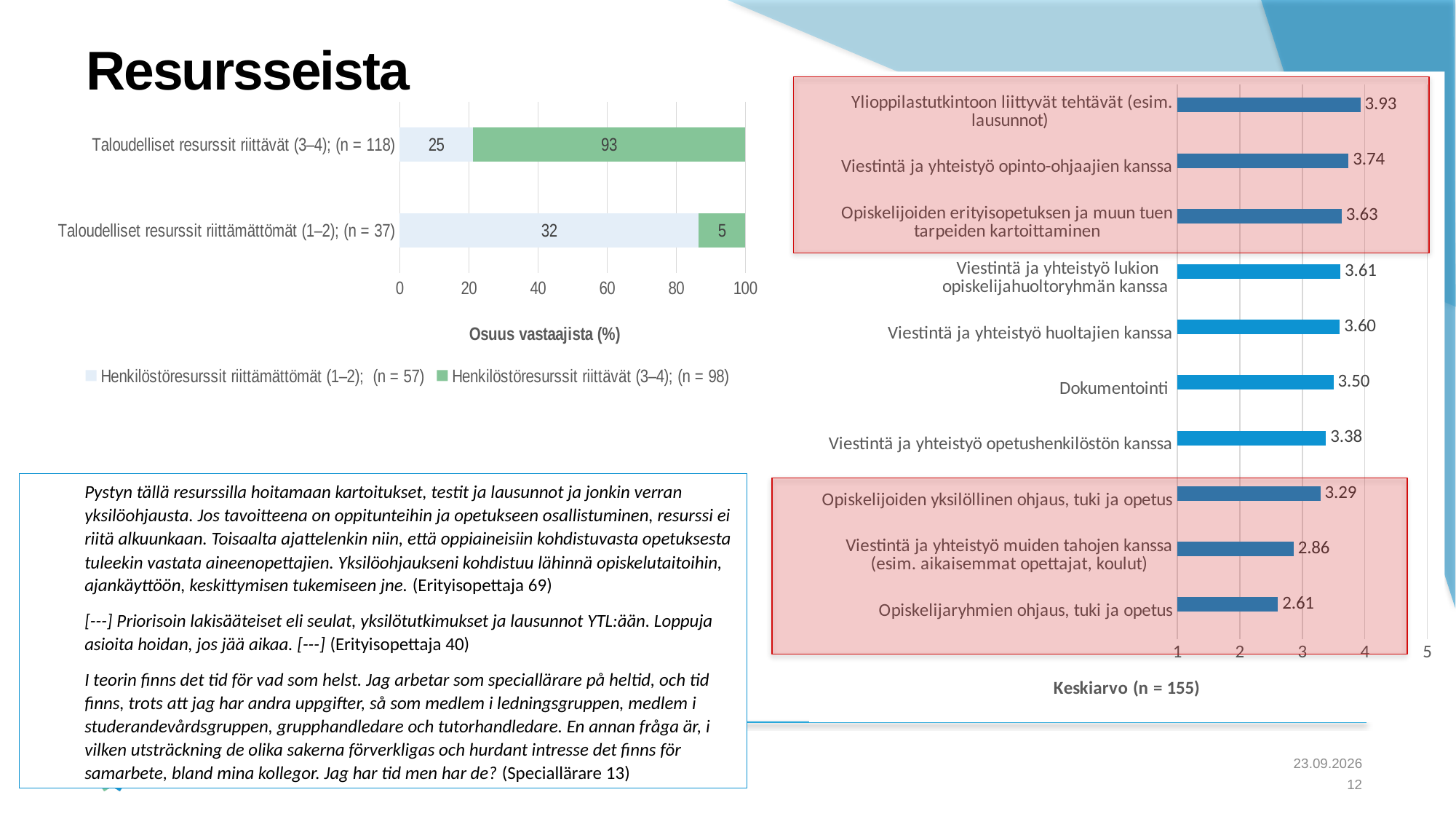
In the 'Keskiarvo (n = 155)' chart on the right, what is the value for 'Dokumentointi'? 3.50 In the 'Keskiarvo (n = 155)' chart on the right, which category has the lowest value? Opiskelijaryhmien ohjaus, tuki ja opetus In the 'Keskiarvo (n = 155)' chart on the right, is the value for 'Viestintä ja yhteistyö opetushenkilöstön kanssa' greater or less than 3? greater What kind of chart is the 'Keskiarvo (n = 155)' chart on the right? Bar chart In the 'Osuus vastaajista (%)' chart on the left, how many series does the legend list? 2 In the 'Keskiarvo (n = 155)' chart on the right, what is the difference between the values for 'Viestintä ja yhteistyö opinto-ohjaajien kanssa' and 'Viestintä ja yhteistyö muiden tahojen kanssa (esim. aikaisemmat opettajat, koulut)'? 0.88 In the 'Osuus vastaajista (%)' chart on the left, what is the total of the two segments for 'Taloudelliset resurssit riittämättömät (1–2); (n = 37)'? 37 In the 'Osuus vastaajista (%)' chart on the left, what is the value of the 'Henkilöstöresurssit riittämättömät (1–2); (n = 57)' segment for 'Taloudelliset resurssit riittämättömät (1–2); (n = 37)'? 32 In the 'Osuus vastaajista (%)' chart on the left, which series is shown in green? Henkilöstöresurssit riittävät (3–4); (n = 98) In the 'Keskiarvo (n = 155)' chart on the right, how many categories are plotted? 10 In the 'Osuus vastaajista (%)' chart on the left, what is the value of the 'Henkilöstöresurssit riittävät (3–4); (n = 98)' segment for 'Taloudelliset resurssit riittävät (3–4); (n = 118)'? 93 In the 'Keskiarvo (n = 155)' chart on the right, which category has the highest value? Ylioppilastutkintoon liittyvät tehtävät (esim. lausunnot)